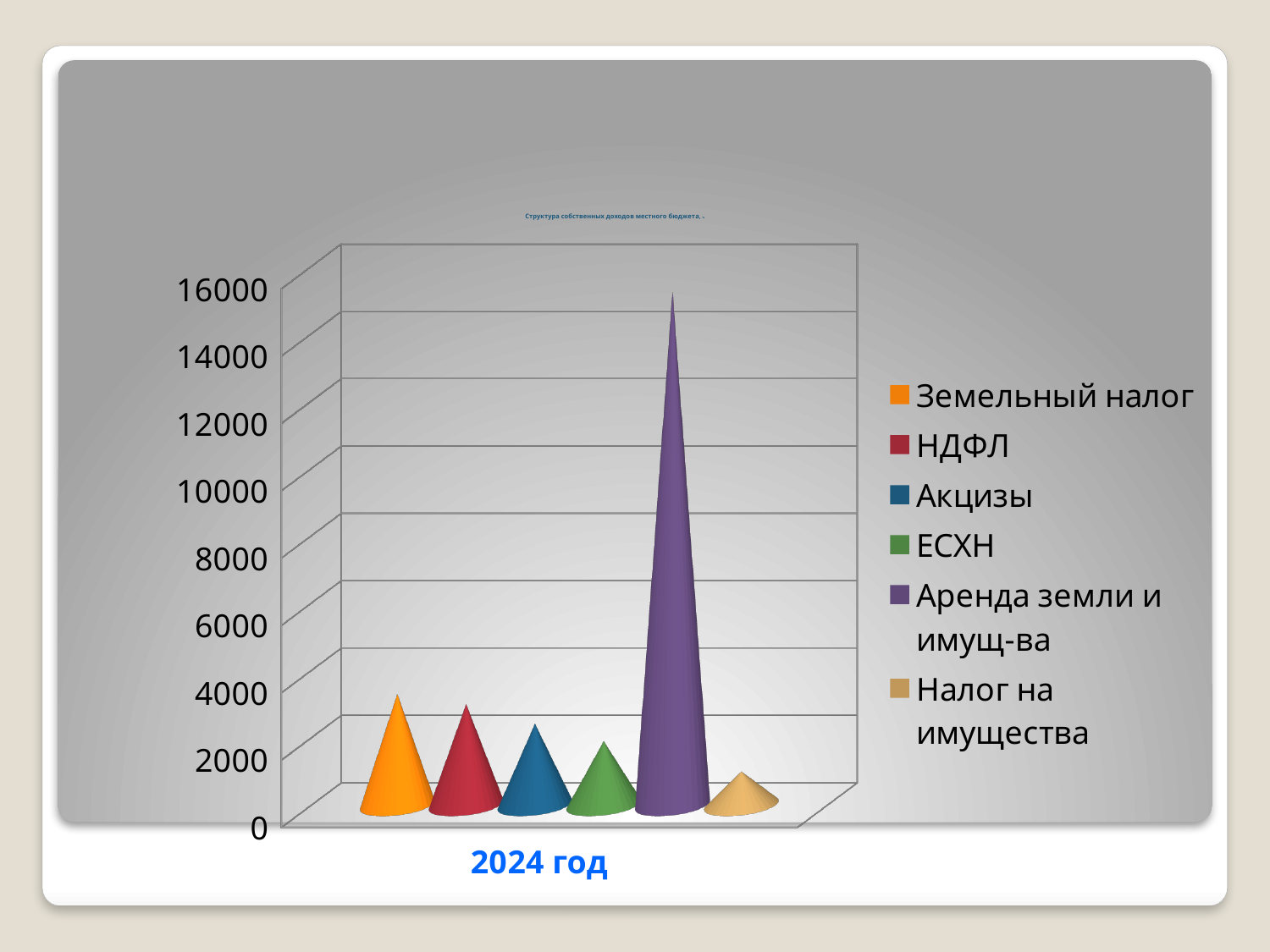
Is the value for Земельный налог greater or less than 4000? less How many categories are shown on the x axis? 1 Is the value for ЕСХН greater or less than 4000? less What kind of chart is shown on the slide? bar chart Which series has the lowest value? Налог на имущества How many series does the legend list? 6 Is the value for Аренда земли и имущ-ва greater or less than 14000? greater Which is larger, the value for НДФЛ or the value for Аренда земли и имущ-ва? Аренда земли и имущ-ва Which series has the highest value? Аренда земли и имущ-ва Which is larger, the value for Земельный налог or the value for ЕСХН? Земельный налог What is the category label on the x axis? 2024 год